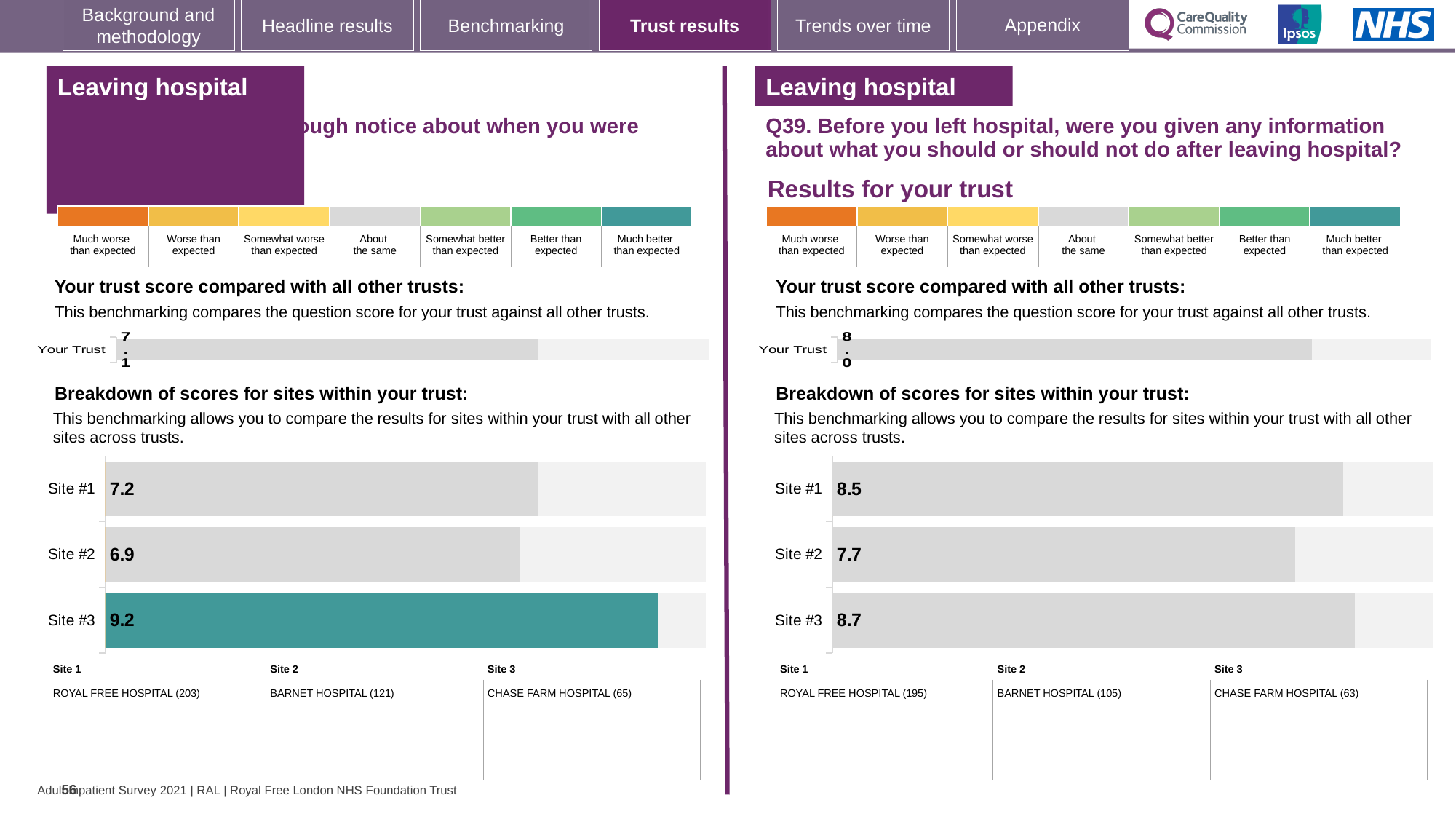
On the right-hand (Q39) site breakdown chart, what is the score for Site #3? 8.7 How many sites are shown on the right-hand (Q39) site breakdown chart? 3 On the right-hand (Q39) 'Your trust score compared with all other trusts' chart, what is the score for Your Trust? 8.0 On the left-hand 'Your trust score compared with all other trusts' chart, what is the score for Your Trust? 7.1 On the left-hand site breakdown chart, which site has the highest score? Site #3 On the right-hand (Q39) site breakdown chart, what is the score for Site #2? 7.7 On the right-hand (Q39) site breakdown chart, what is the difference between the scores for Site #1 and Site #2? 0.8 On the right-hand (Q39) site breakdown chart, which site has the lowest score? Site #2 On the left-hand site breakdown chart, what is the difference between the scores for Site #3 and Site #2? 2.3 On the left-hand site breakdown chart, what is the score for Site #1? 7.2 On the left-hand site breakdown chart, which site has the lowest score? Site #2 On the left-hand site breakdown chart, what is the score for Site #3? 9.2